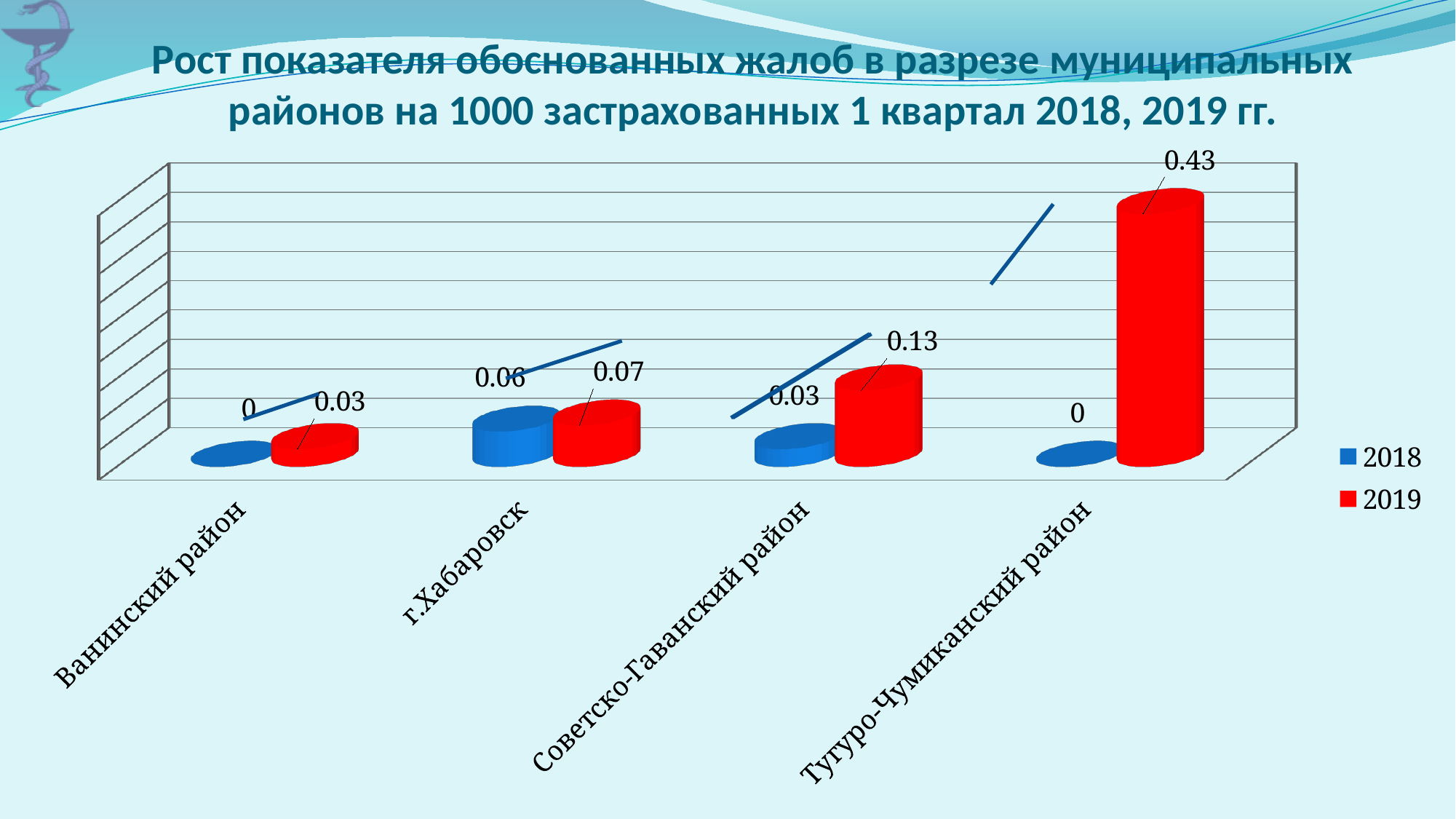
Which category has the lowest 2019 value? Ванинский район How many series does the legend list? 2 What is the 2019 value for Тугуро-Чумиканский район? 0.43 What is the 2019 value for Советско-Гаванский район? 0.13 Which category has the highest 2019 value? Тугуро-Чумиканский район What kind of chart is shown on the slide? Bar chart How many categories are shown on the x axis? 4 Which is larger for г.Хабаровск: the 2018 value or the 2019 value? 2019 Which category has the highest 2018 value? г.Хабаровск What is the 2018 value for Ванинский район? 0 What is the 2018 value for г.Хабаровск? 0.06 What is the difference between the 2019 and 2018 values for Советско-Гаванский район? 0.1